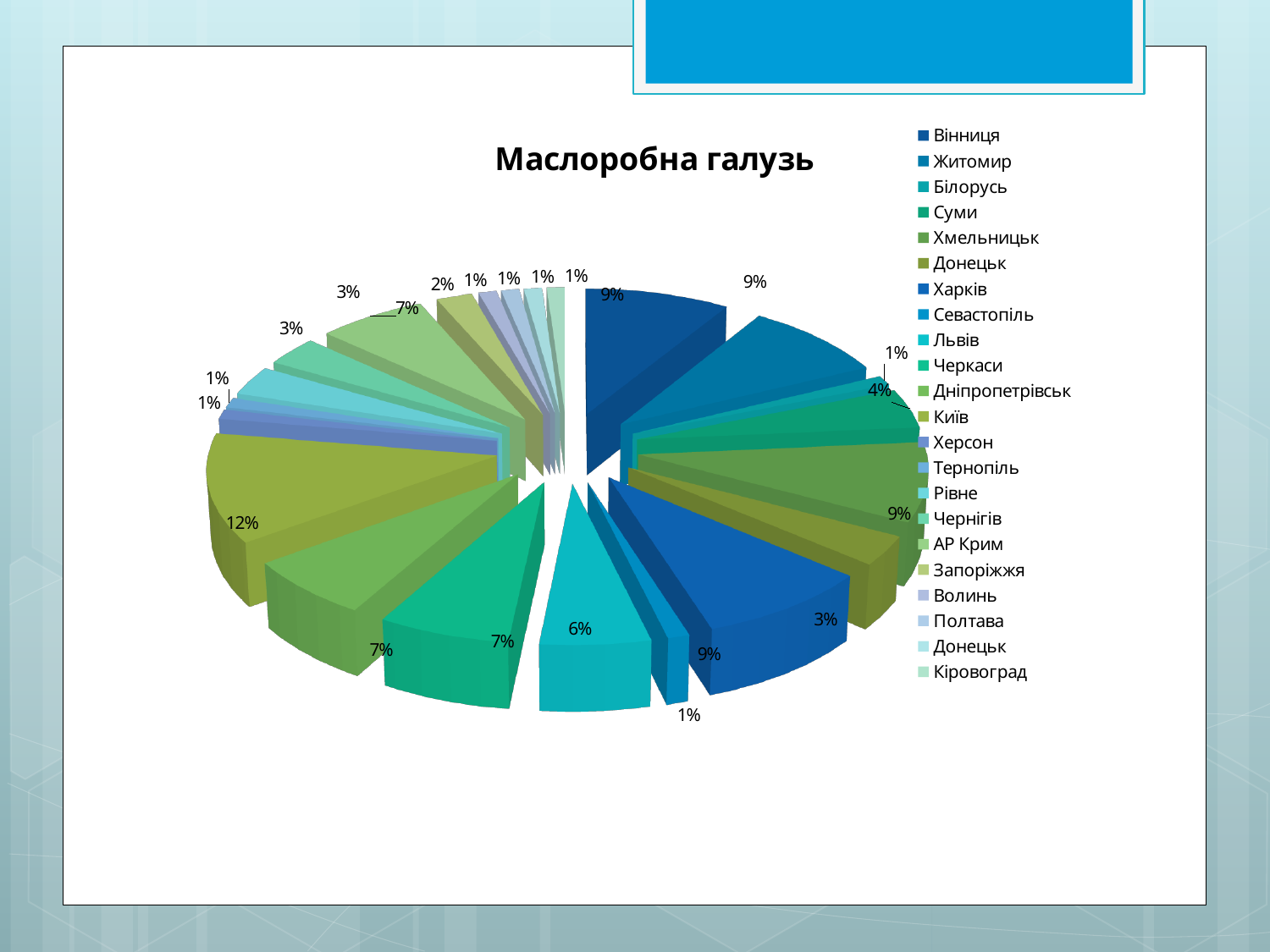
What is the title of the chart? Маслоробна галузь What is the difference between the share for Київ and the share for Вінниця? 3 percentage points What is the value shown for Вінниця? 9% What is the value shown for Запоріжжя? 2% What is the smallest percentage labelled on the pie chart? 1% Which is larger, the slice for Київ or the slice for Вінниця? Київ What kind of chart is shown on the slide? pie chart What is the largest percentage labelled on the pie chart? 12% What is the value shown for Львів? 6% What share of the pie does Київ have? 12% Which category has the largest slice in the pie chart? Київ How many categories does the legend of the pie chart list? 22